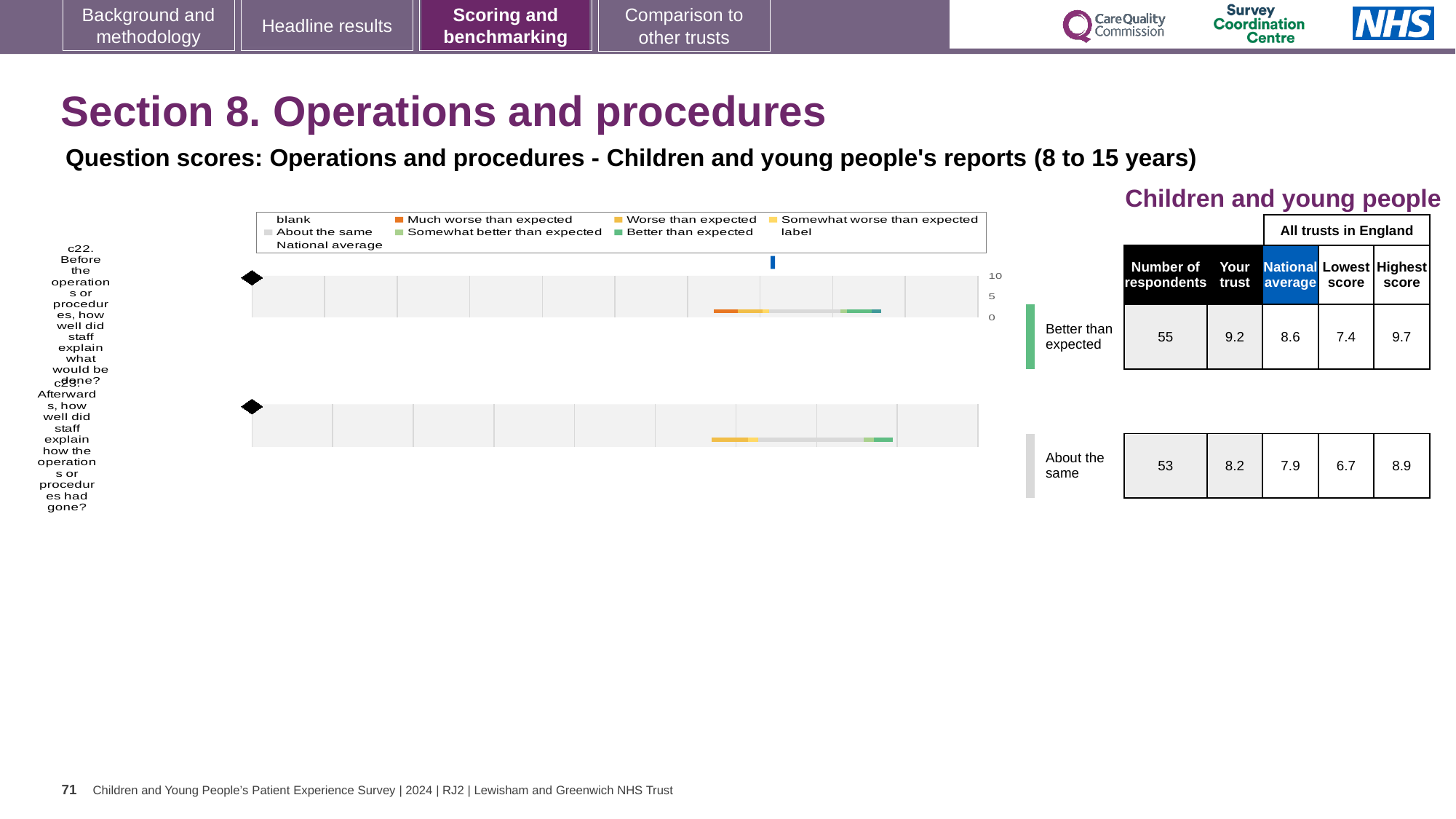
What benchmark category is shown for question c23? About the same What is the difference between the 'Your trust' score and the National average for question c22? 0.6 What is the difference between the highest and lowest scores across all trusts in England for question c23? 2.2 What is the National average score for question c22? 8.6 What is the highest score among all trusts in England for question c23? 8.9 What is the 'Your trust' score for question c23 (Afterwards, how well did staff explain how the operations or procedures had gone?)? 8.2 What kind of chart is used to show the question scores for c22 and c23? bar chart For question c22, which is larger: the 'Your trust' score or the National average? Your trust How many questions (c22 and c23) are plotted as bars on the slide? 2 What is the National average score for question c23? 7.9 How many respondents answered question c22? 55 What is the 'Your trust' score for question c22 (Before the operations or procedures, how well did staff explain what would be done?)? 9.2